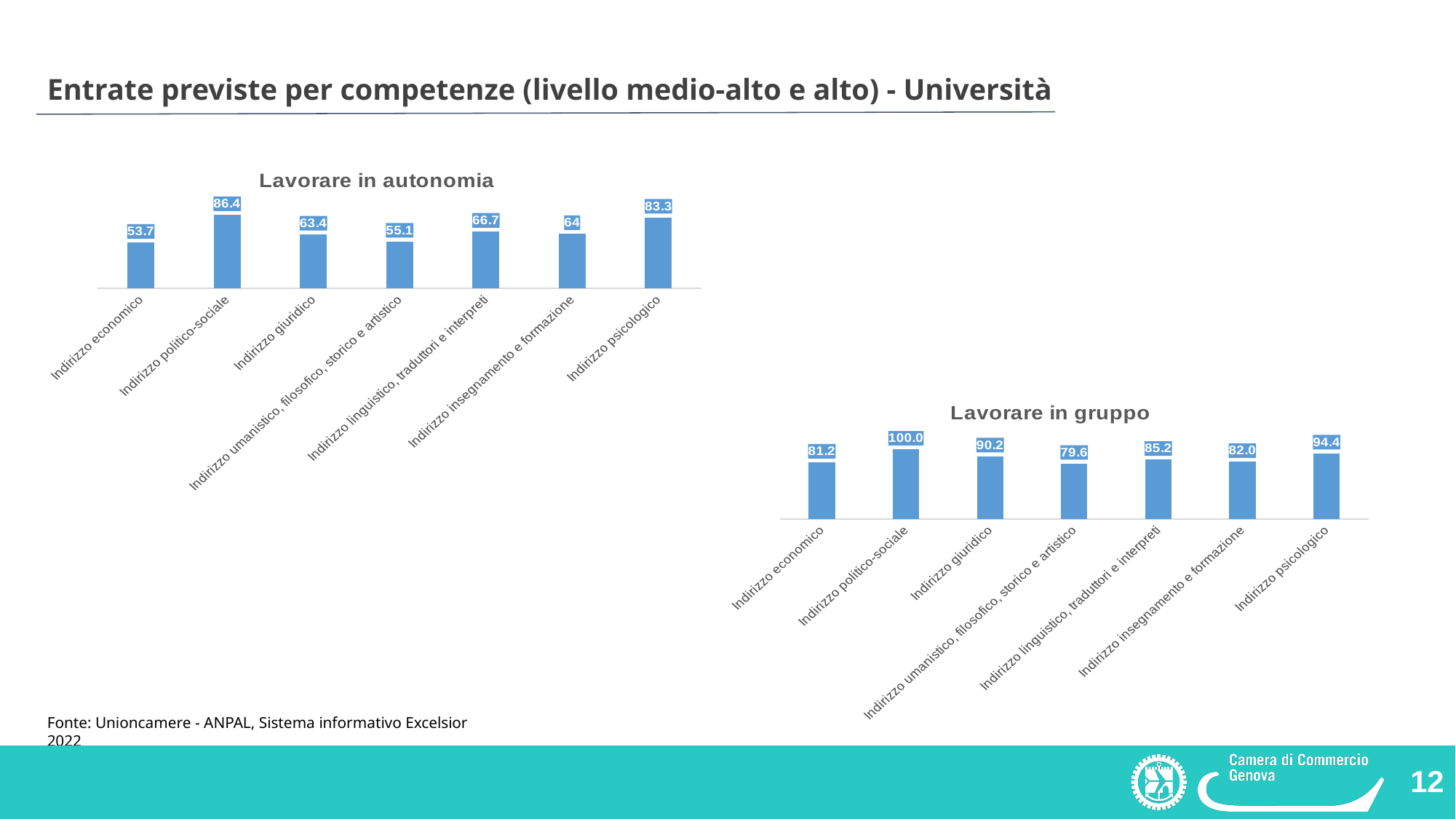
What is the title of the chart on the right side of the slide? Lavorare in gruppo In the 'Lavorare in gruppo' chart, what is the value for Indirizzo insegnamento e formazione? 82.0 In the 'Lavorare in gruppo' chart, what is the value for Indirizzo giuridico? 90.2 In the 'Lavorare in gruppo' chart, which category has the lowest value? Indirizzo umanistico, filosofico, storico e artistico In the 'Lavorare in autonomia' chart, which category has the lowest value? Indirizzo economico In the 'Lavorare in gruppo' chart, what is the difference between Indirizzo politico-sociale and Indirizzo psicologico? 5.6 In the 'Lavorare in autonomia' chart, what is the value for Indirizzo economico? 53.7 How many categories are shown in the 'Lavorare in gruppo' chart? 7 In the 'Lavorare in autonomia' chart, which is larger: Indirizzo linguistico, traduttori e interpreti or Indirizzo insegnamento e formazione? Indirizzo linguistico, traduttori e interpreti What type of chart is 'Lavorare in autonomia'? Bar chart In the 'Lavorare in autonomia' chart, which category has the highest value? Indirizzo politico-sociale In the 'Lavorare in autonomia' chart, what is the difference between Indirizzo psicologico and Indirizzo economico? 29.6